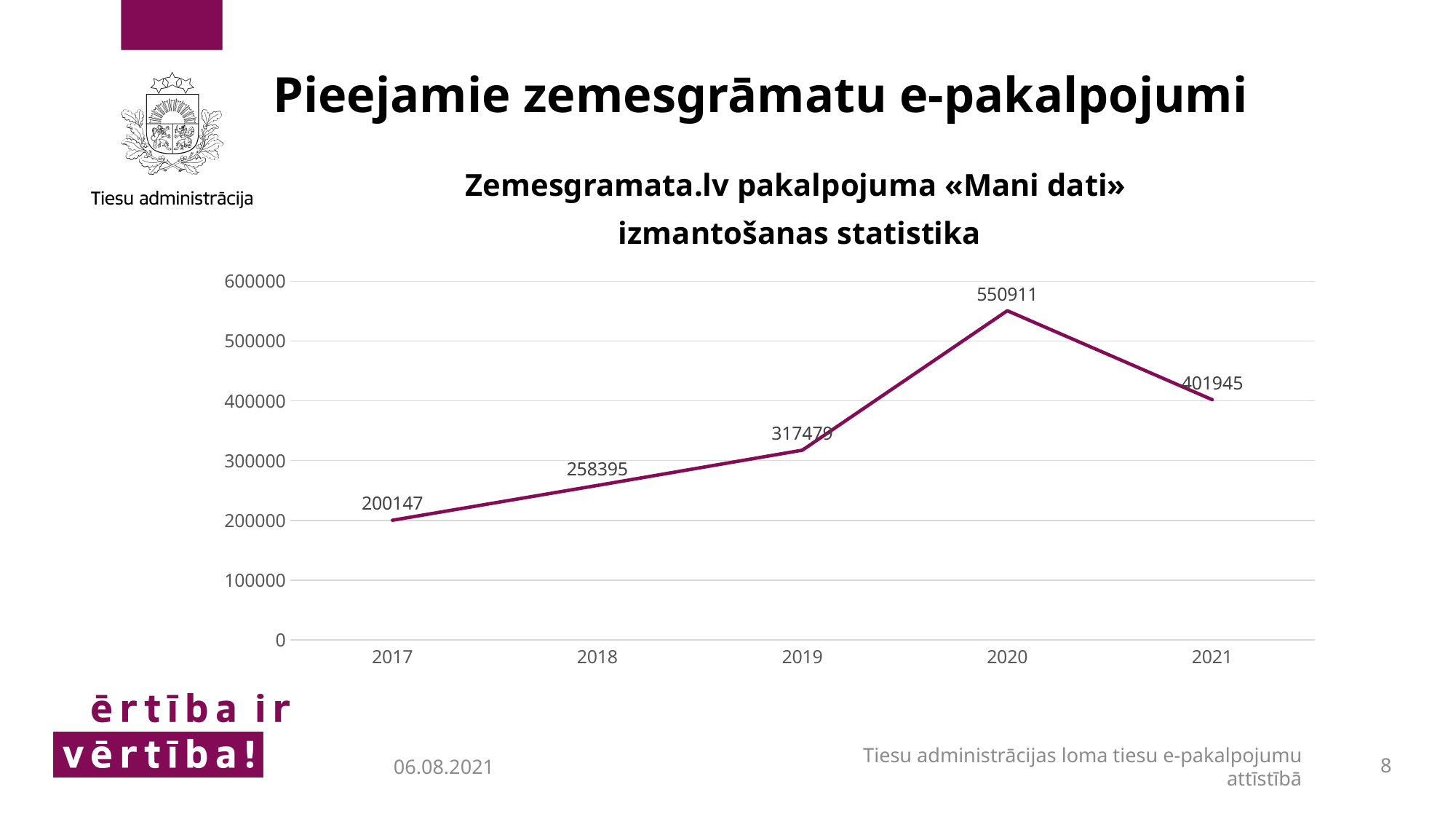
Is the value for 2019 greater or less than 300000? greater What is the value for 2020? 550911 Which is larger, the value for 2021 or the value for 2019? 2021 What is the difference between the values for 2020 and 2021? 148966 What is the value for 2018? 258395 What is the difference between the values for 2018 and 2017? 58248 What kind of chart is shown on the slide? line chart Which year has the highest value? 2020 Which year has the lowest value? 2017 How many years are plotted on the chart? 5 What is the value for 2017? 200147 What is the value for 2021? 401945